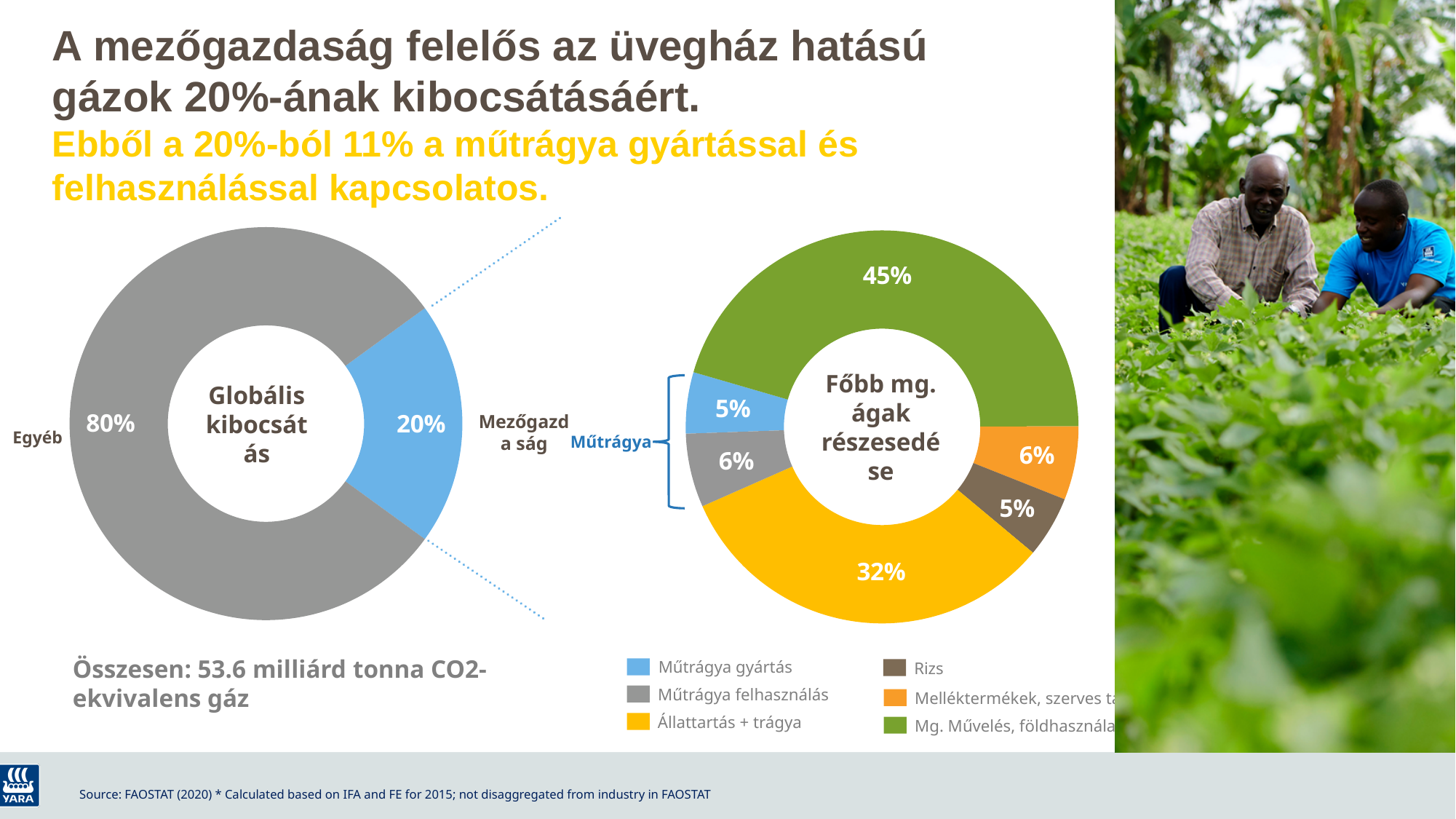
On the right chart (Főbb mg. ágak részesedése), which category has the largest share? Mg. Művelés, földhasználat (45%) On the right chart (Főbb mg. ágak részesedése), what colour is the Állattartás + trágya slice? Yellow On the left chart (Globális kibocsátás), what share is labelled for Egyéb? 80% On the right chart (Főbb mg. ágak részesedése), what share is shown for Műtrágya felhasználás? 6% On the right chart (Főbb mg. ágak részesedése), which is larger: Műtrágya felhasználás or Műtrágya gyártás? Műtrágya felhasználás On the left chart (Globális kibocsátás), what share is labelled for Mezőgazdaság? 20% On the right chart (Főbb mg. ágak részesedése), what share is shown for Állattartás + trágya? 32% What kind of chart is the left chart titled Globális kibocsátás? Pie (donut) chart On the right chart (Főbb mg. ágak részesedése), what share is shown for Műtrágya gyártás? 5% On the right chart (Főbb mg. ágak részesedése), what share is shown for Rizs? 5% On the right chart (Főbb mg. ágak részesedése), what is the difference between the shares of Állattartás + trágya and Műtrágya felhasználás? 26 percentage points On the right chart (Főbb mg. ágak részesedése), how many categories does the legend list? 6